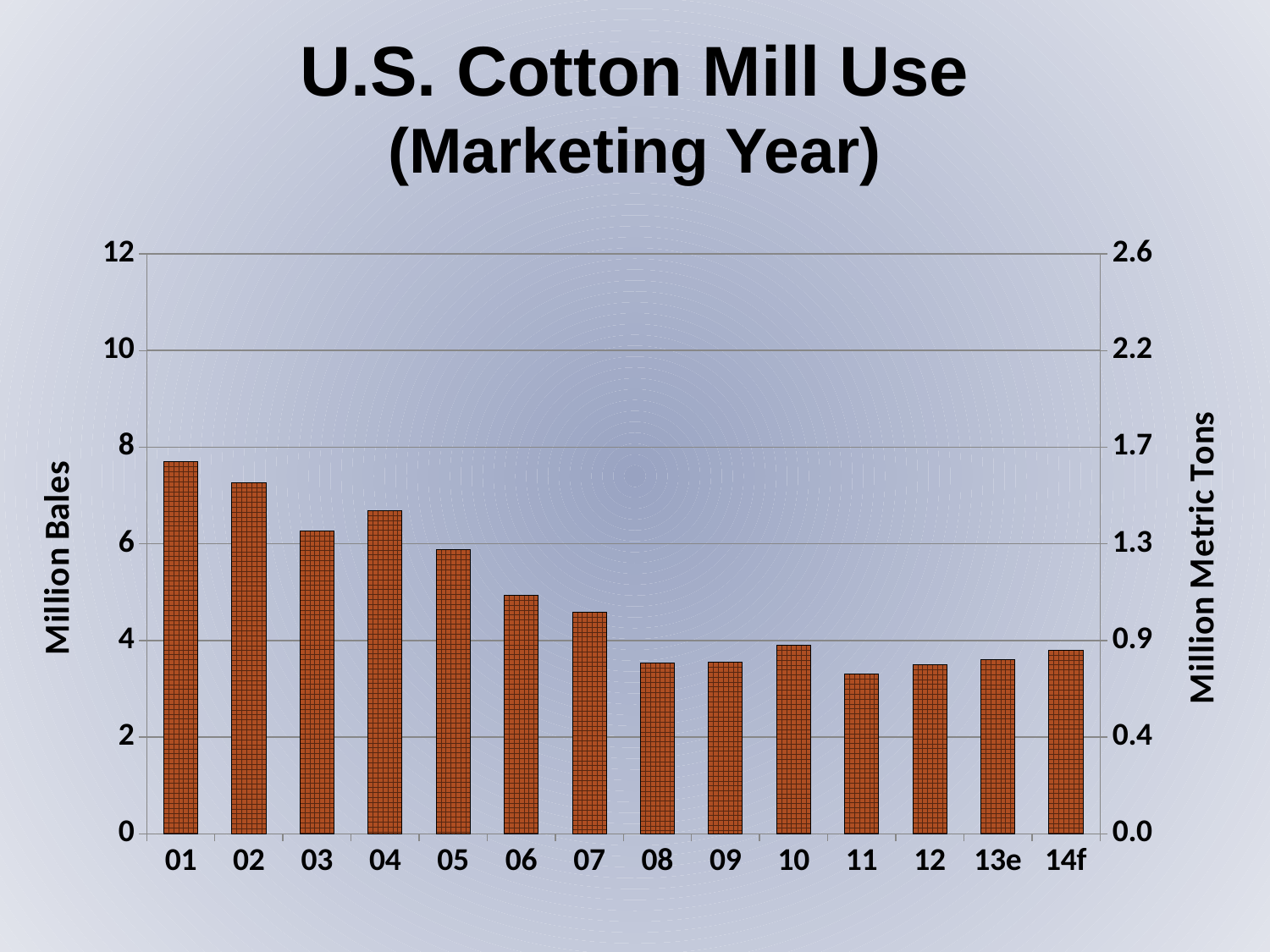
What kind of chart is shown on the slide? Bar chart Which is larger, the value for 04 or the value for 03? 04 How many marketing years are plotted on the chart? 14 Which is larger, the value for 02 or the value for 03? 02 Which marketing year has the lowest cotton mill use? 11 Is the value for 01 greater or less than 6 million bales? greater Is the value for 08 greater or less than 4 million bales? less Overall, do the values rise or fall from 01 to 14f? Fall Is the value for 07 greater or less than 4 million bales? greater Which marketing year has the highest cotton mill use? 01 What is the label on the left vertical axis? Million Bales